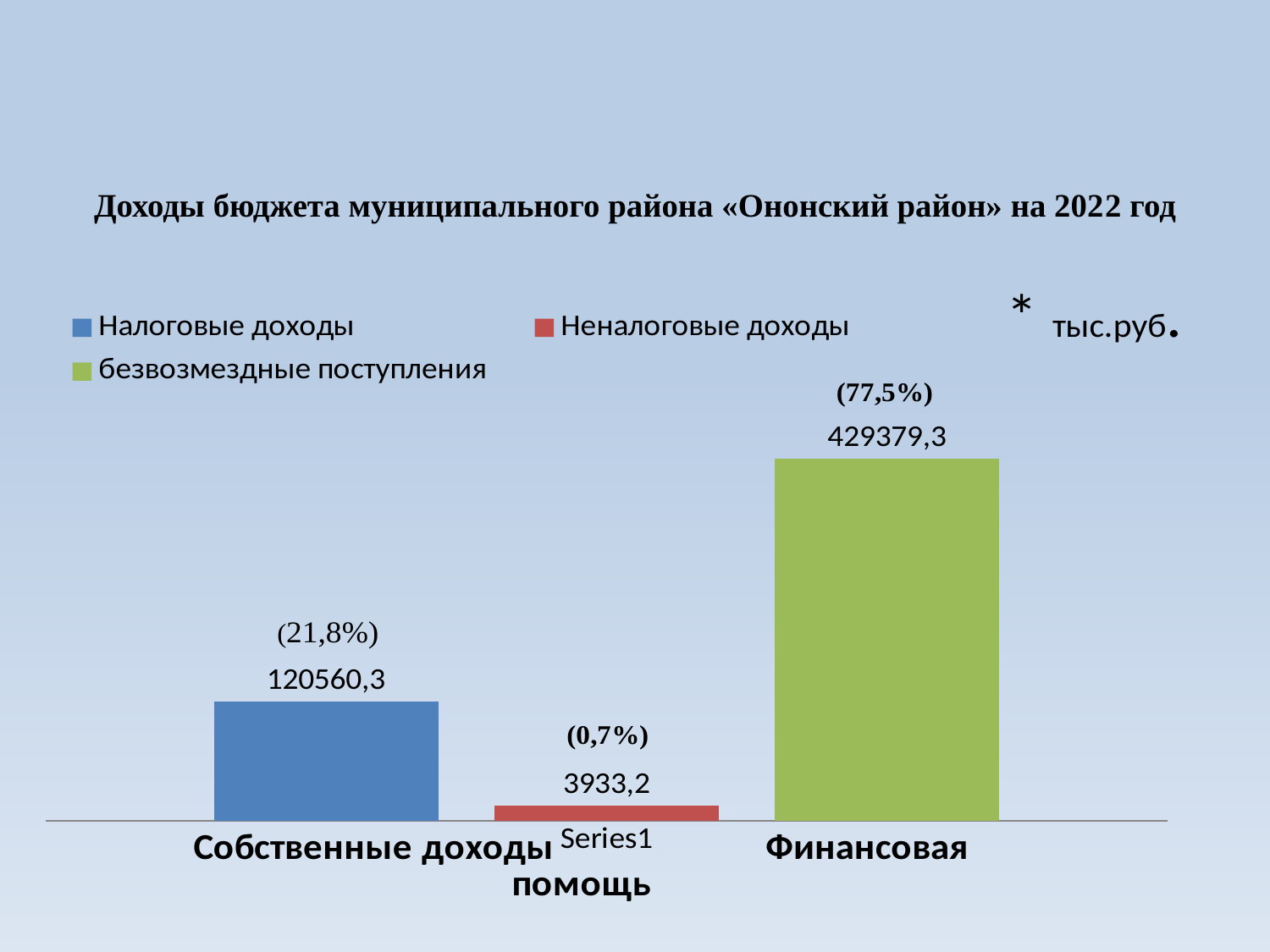
What percentage share is shown above the bar for безвозмездные поступления? (77,5%) What is the value for Налоговые доходы? 120560,3 What is the value for Неналоговые доходы? 3933,2 What kind of chart is shown on the slide? Bar chart What percentage share is shown above the bar for Налоговые доходы? (21,8%) Which is larger, Налоговые доходы or Неналоговые доходы? Налоговые доходы Which series has the highest value? безвозмездные поступления What is the difference between Налоговые доходы and Неналоговые доходы? 116627,1 What is the difference between безвозмездные поступления and Налоговые доходы? 308819 Which series has the lowest value? Неналоговые доходы How many series does the legend list? 3 What is the value for безвозмездные поступления? 429379,3